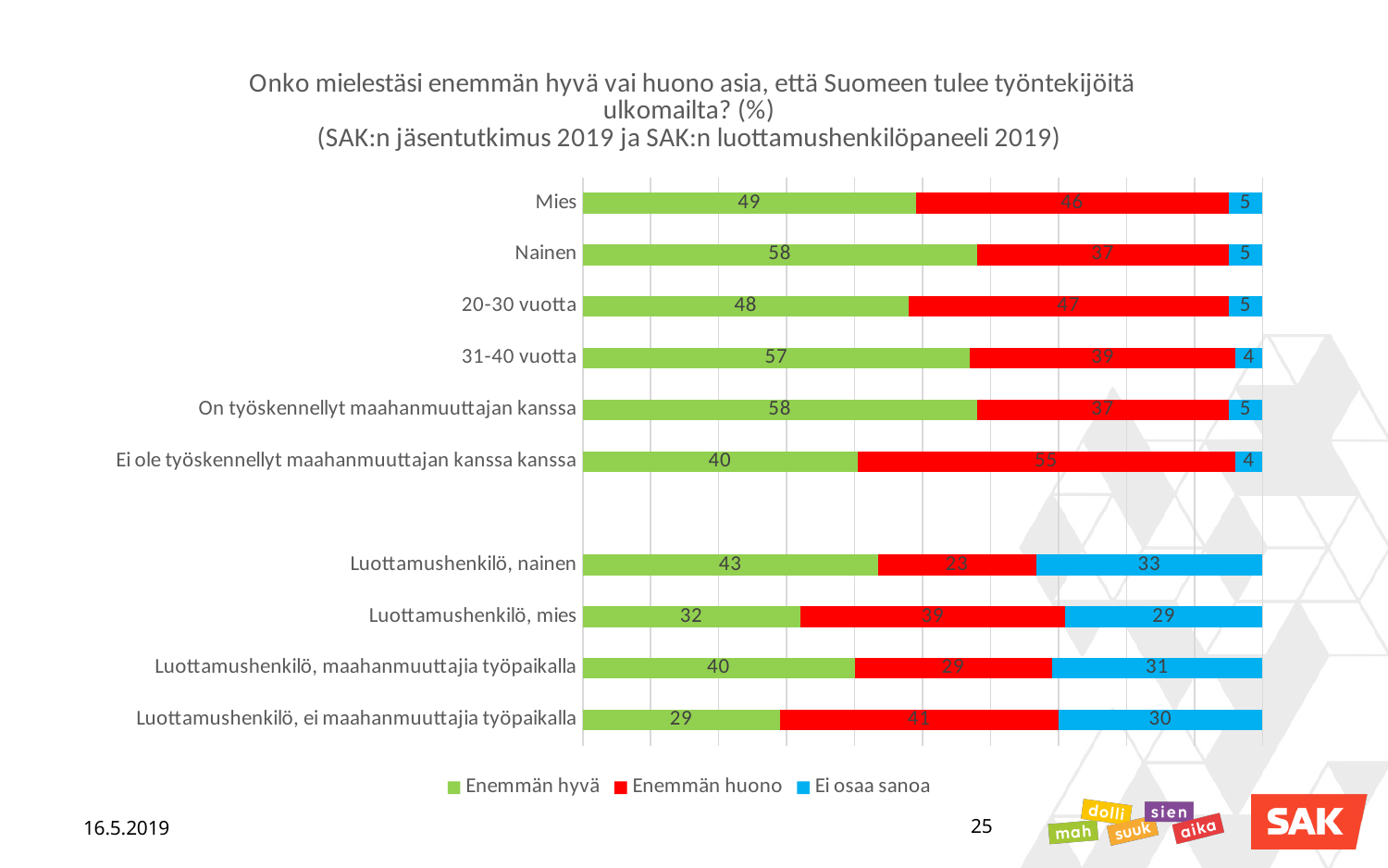
What is the difference between the "Enemmän hyvä" values for "Nainen" and "Mies"? 9 What kind of chart is shown on the slide? Stacked bar chart What is the value of "Enemmän huono" for "Ei ole työskennellyt maahanmuuttajan kanssa kanssa"? 55 Which category has the highest "Enemmän huono" value? Ei ole työskennellyt maahanmuuttajan kanssa kanssa How many categories are shown in the chart? 10 What is the total of the stacked bar for "Luottamushenkilö, mies"? 100 How many series does the legend list? 3 What is the value of "Enemmän hyvä" for "Mies"? 49 Which category has the lowest "Enemmän hyvä" value? Luottamushenkilö, ei maahanmuuttajia työpaikalla What is the value of "Ei osaa sanoa" for "Luottamushenkilö, nainen"? 33 Which colour represents "Ei osaa sanoa" in the chart? Blue Which is larger: the "Enemmän huono" value for "Luottamushenkilö, mies" or for "Luottamushenkilö, nainen"? Luottamushenkilö, mies